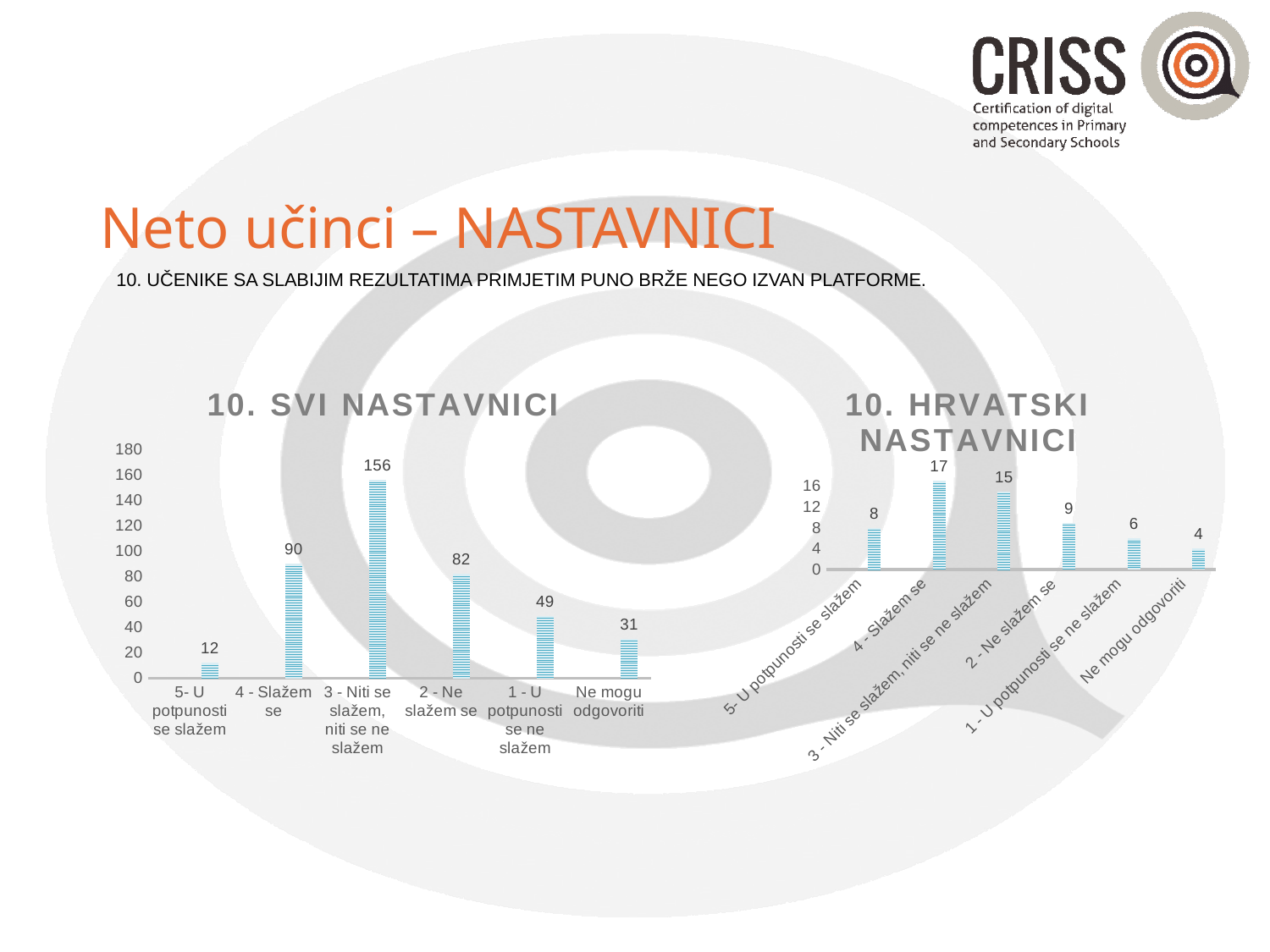
In the '10. HRVATSKI NASTAVNICI' chart, do the values rise or fall from '2 - Ne slažem se' to 'Ne mogu odgovoriti'? Fall In the '10. HRVATSKI NASTAVNICI' chart, which category has the highest value? 4 - Slažem se What is the title of the chart on the right side of the slide? 10. HRVATSKI NASTAVNICI In the '10. SVI NASTAVNICI' chart, which category has the lowest value? 5- U potpunosti se slažem In the '10. SVI NASTAVNICI' chart, what is the value for '3 - Niti se slažem, niti se ne slažem'? 156 In the '10. SVI NASTAVNICI' chart, which is larger: '1 - U potpunosti se ne slažem' or 'Ne mogu odgovoriti'? 1 - U potpunosti se ne slažem In the '10. HRVATSKI NASTAVNICI' chart, what is the value for 'Ne mogu odgovoriti'? 4 In the '10. SVI NASTAVNICI' chart, what is the difference between '4 - Slažem se' and '2 - Ne slažem se'? 8 How many categories are shown in the '10. SVI NASTAVNICI' chart? 6 In the '10. HRVATSKI NASTAVNICI' chart, what is the value for '4 - Slažem se'? 17 In the '10. HRVATSKI NASTAVNICI' chart, what is the difference between '3 - Niti se slažem, niti se ne slažem' and '2 - Ne slažem se'? 6 What kind of chart is '10. SVI NASTAVNICI'? Bar chart